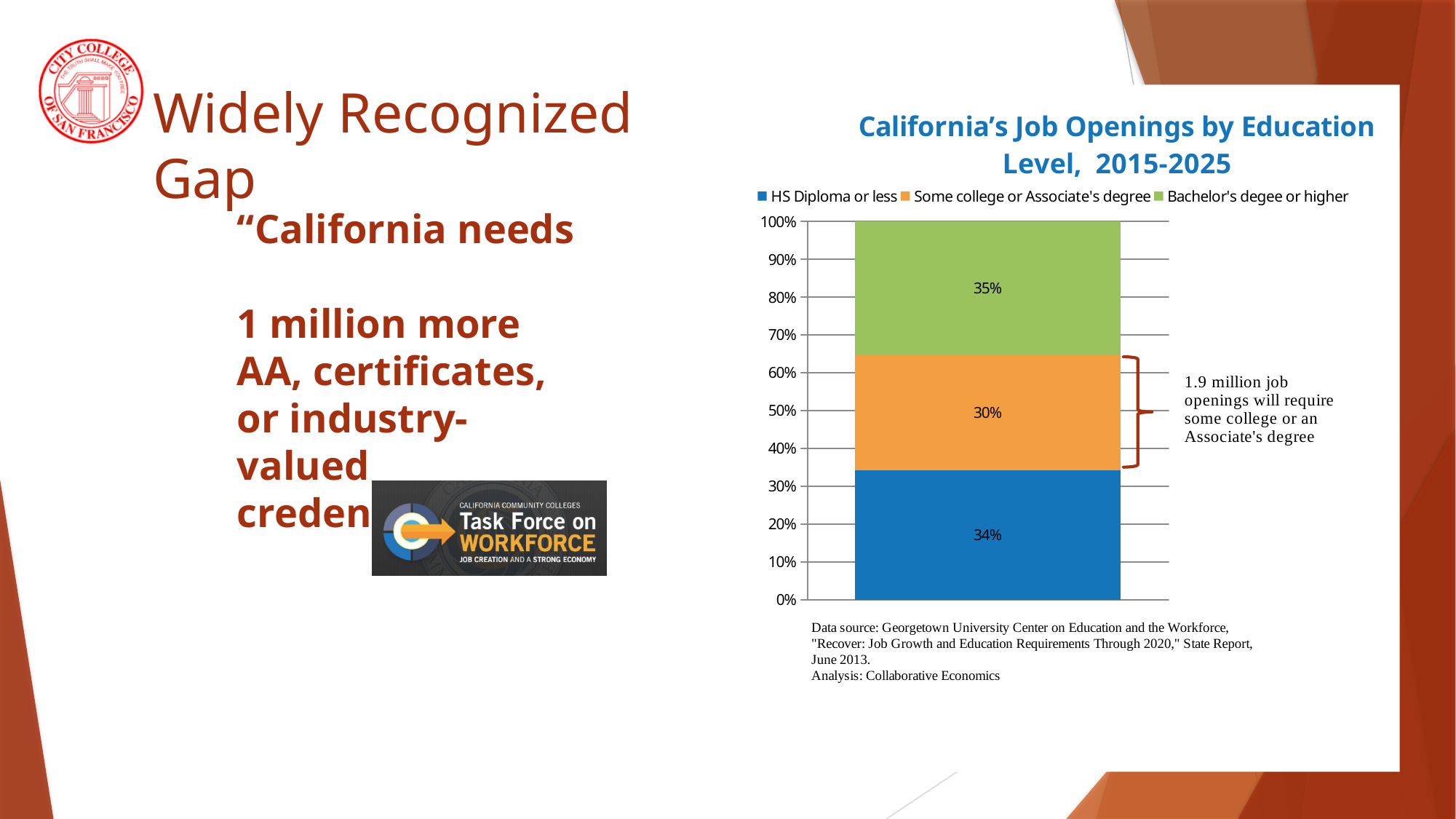
What percentage of California's job openings require a HS Diploma or less? 34% Which education level has the smallest share of job openings in the chart? Some college or Associate's degree What percentage of California's job openings require a Bachelor's degree or higher? 35% Which colour represents the 'Some college or Associate's degree' series? Orange What is the title of the chart? California's Job Openings by Education Level, 2015-2025 What kind of chart is shown on the slide? Stacked bar chart Which education level has the largest share of job openings in the chart? Bachelor's degee or higher Which is larger: the share for HS Diploma or less or the share for some college or Associate's degree? HS Diploma or less What is the difference between the share for Bachelor's degree or higher and the share for some college or Associate's degree? 5% How many series does the chart legend list? 3 According to the chart annotation, how many job openings will require some college or an Associate's degree? 1.9 million What percentage of California's job openings require some college or an Associate's degree? 30%